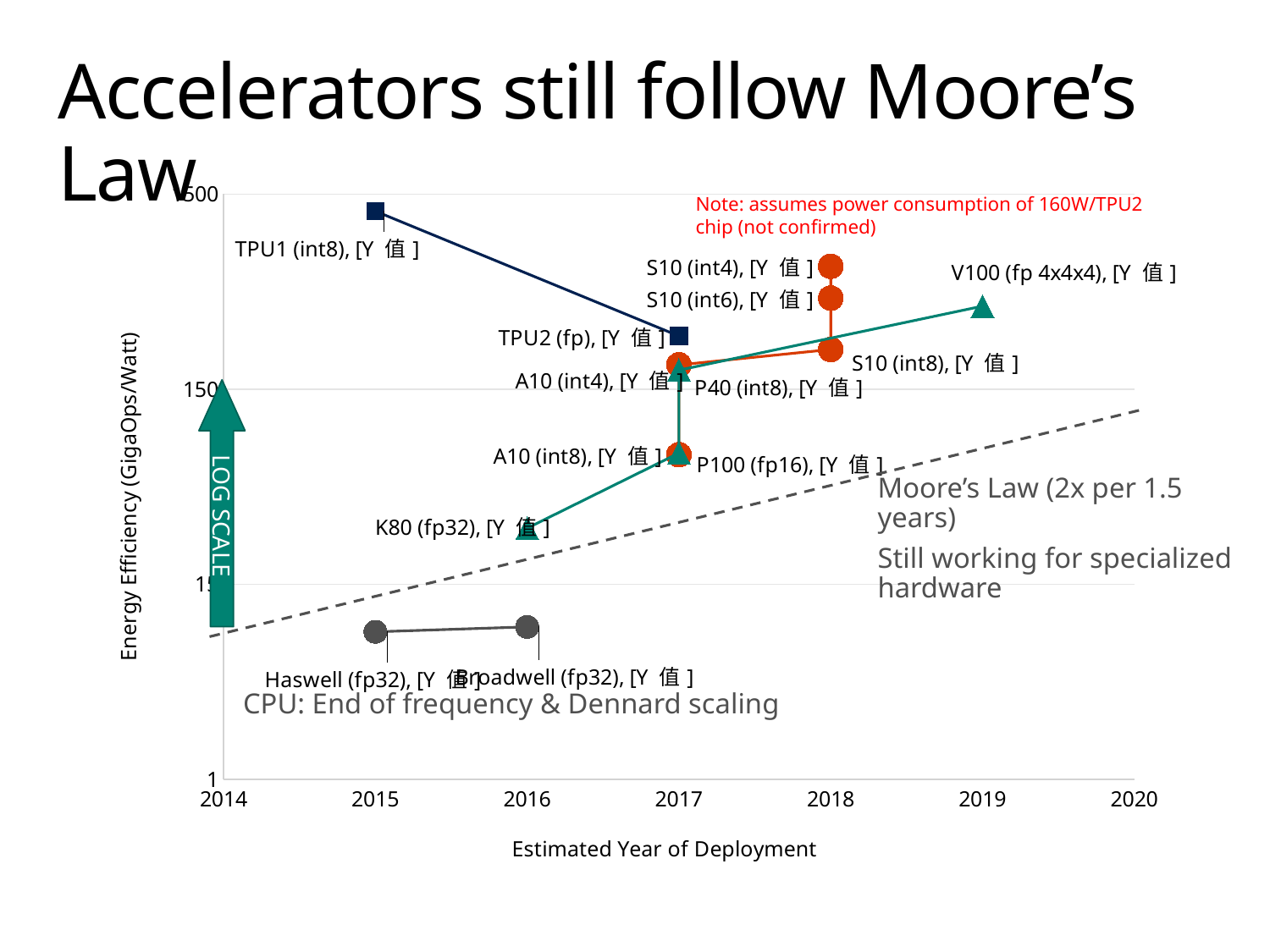
Which has the higher energy efficiency, TPU1 (int8) or TPU2 (fp)? TPU1 (int8) Which has the higher energy efficiency, S10 (int4) or S10 (int8)? S10 (int4) How many labeled data points are plotted on the chart? 13 Is the value for K80 (fp32) greater or less than 150? less What is the title of the chart's y axis? Energy Efficiency (GigaOps/Watt) Which labeled point has the highest energy efficiency on the chart? TPU1 (int8) Is the value for TPU1 (int8) greater or less than 150? greater Is the value for Haswell (fp32) greater or less than 15? less What is the title of the chart's x axis? Estimated Year of Deployment Which has the higher energy efficiency, K80 (fp32) or V100 (fp 4x4x4)? V100 (fp 4x4x4)